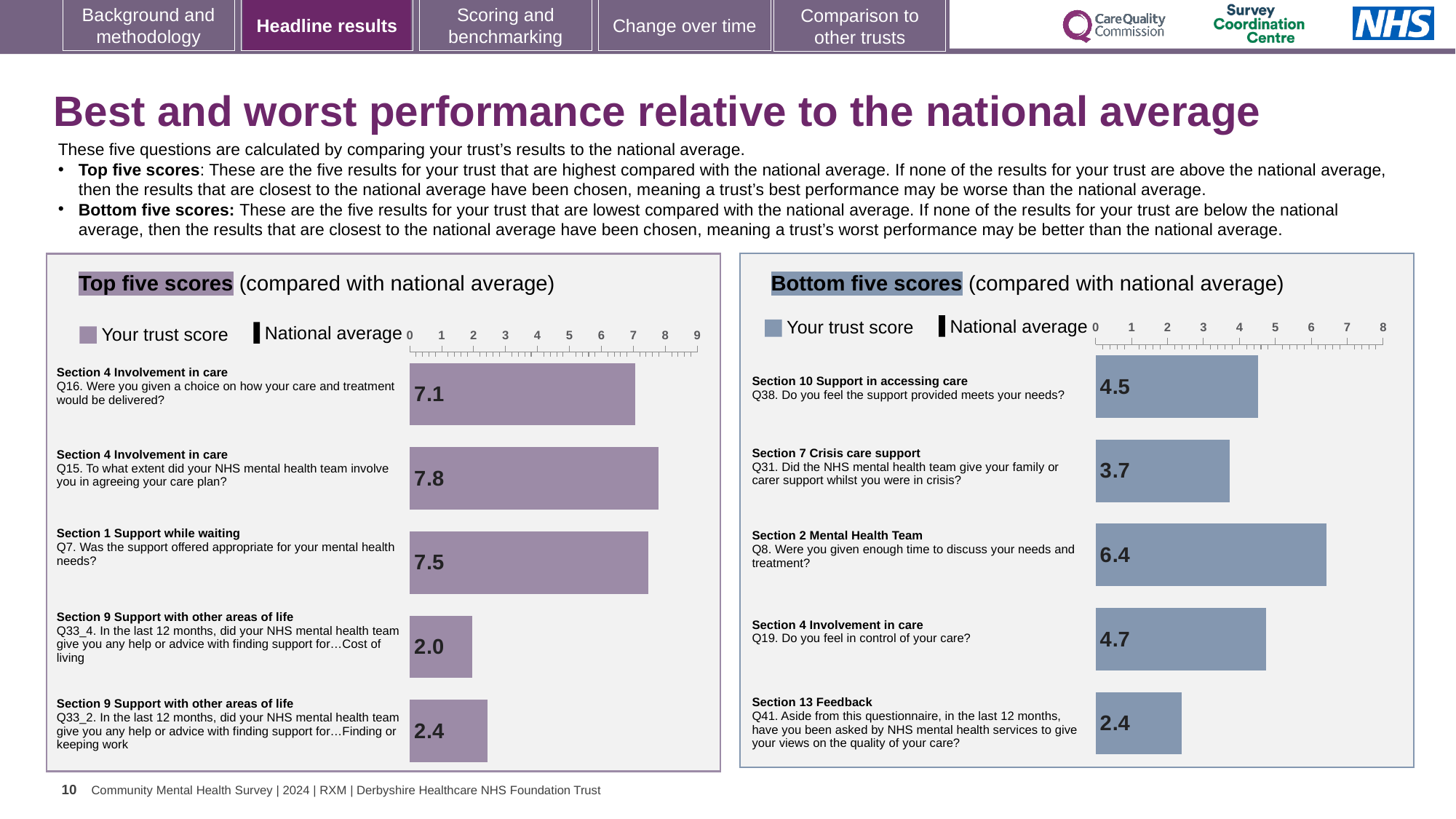
In the Bottom five scores chart, which has the larger trust score, Q38 or Q19? Q19 What kind of chart is the Top five scores chart? Bar chart In the Bottom five scores chart, which question has the lowest trust score? Q41 In the Bottom five scores chart, what is the trust score for Q8 (Were you given enough time to discuss your needs and treatment?)? 6.4 In the Top five scores chart, what is the trust score for Q15 (To what extent did your NHS mental health team involve you in agreeing your care plan?)? 7.8 In the Bottom five scores chart, what is the trust score for Q41 (Section 13 Feedback)? 2.4 In the Top five scores chart, what is the trust score for Q33_4 (help or advice with finding support for cost of living)? 2.0 What is the highest tick value shown on the axis of the Top five scores chart? 9 How many bars are plotted in the Bottom five scores chart? 5 In the Bottom five scores chart, what is the difference between the trust scores for Q19 and Q31? 1.0 In the Top five scores chart, which question has the highest trust score? Q15 In the Top five scores chart, what is the difference between the trust scores for Q16 and Q7? 0.4